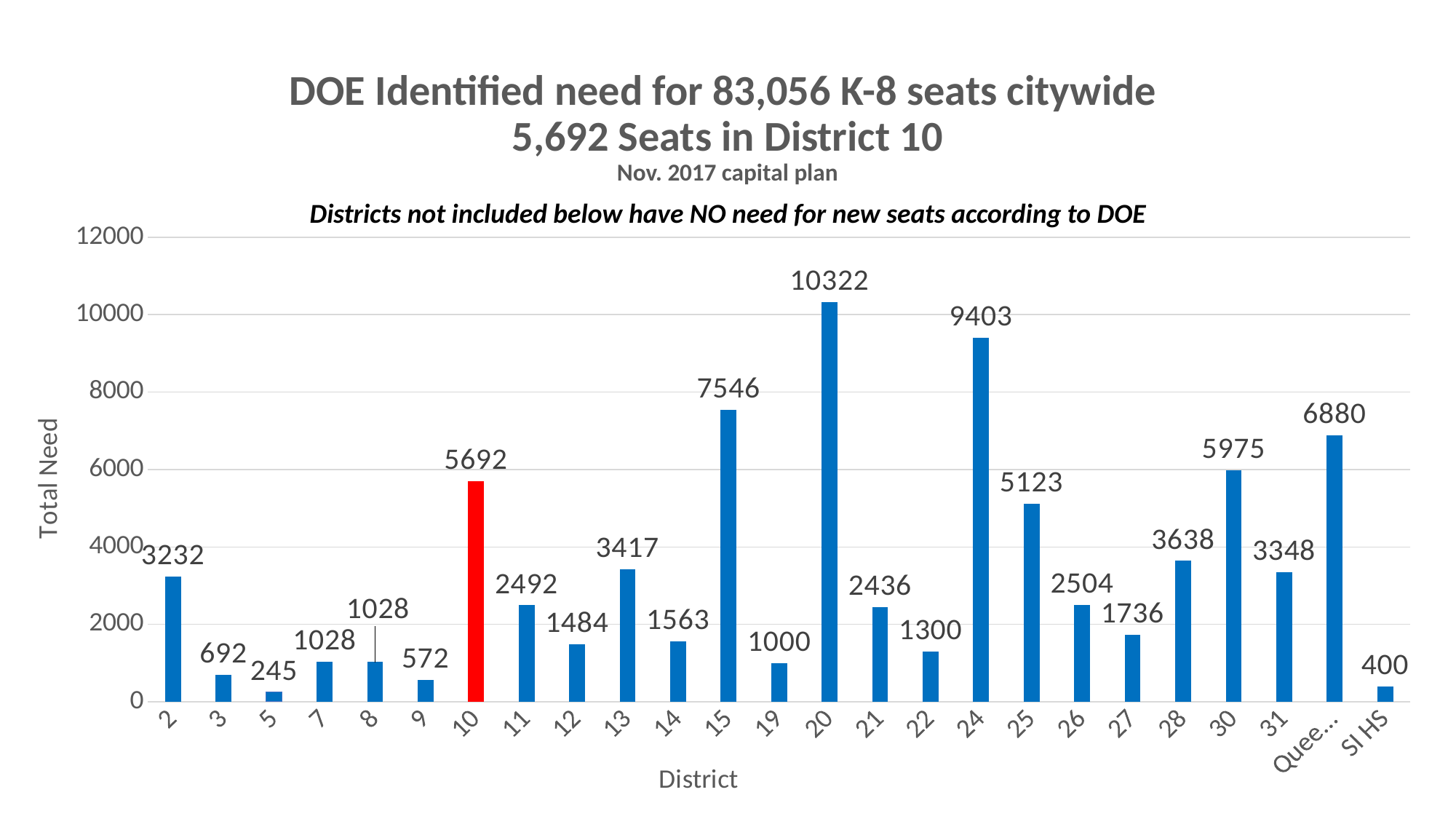
What kind of chart is shown on the slide? Bar chart What is the difference in total need between District 20 and District 24? 919 What is the total need for SI HS? 400 Is the value for District 28 greater or less than 4000? less Which bar is coloured red instead of blue? District 10 How many districts/categories are shown on the x axis? 25 Which has a larger total need, District 30 or District 25? District 30 What is the total need for District 10? 5692 Which district has the highest total need? 20 What is the total need for District 15? 7546 What is the difference in total need between District 10 and District 11? 3200 Which district has the lowest total need? 5